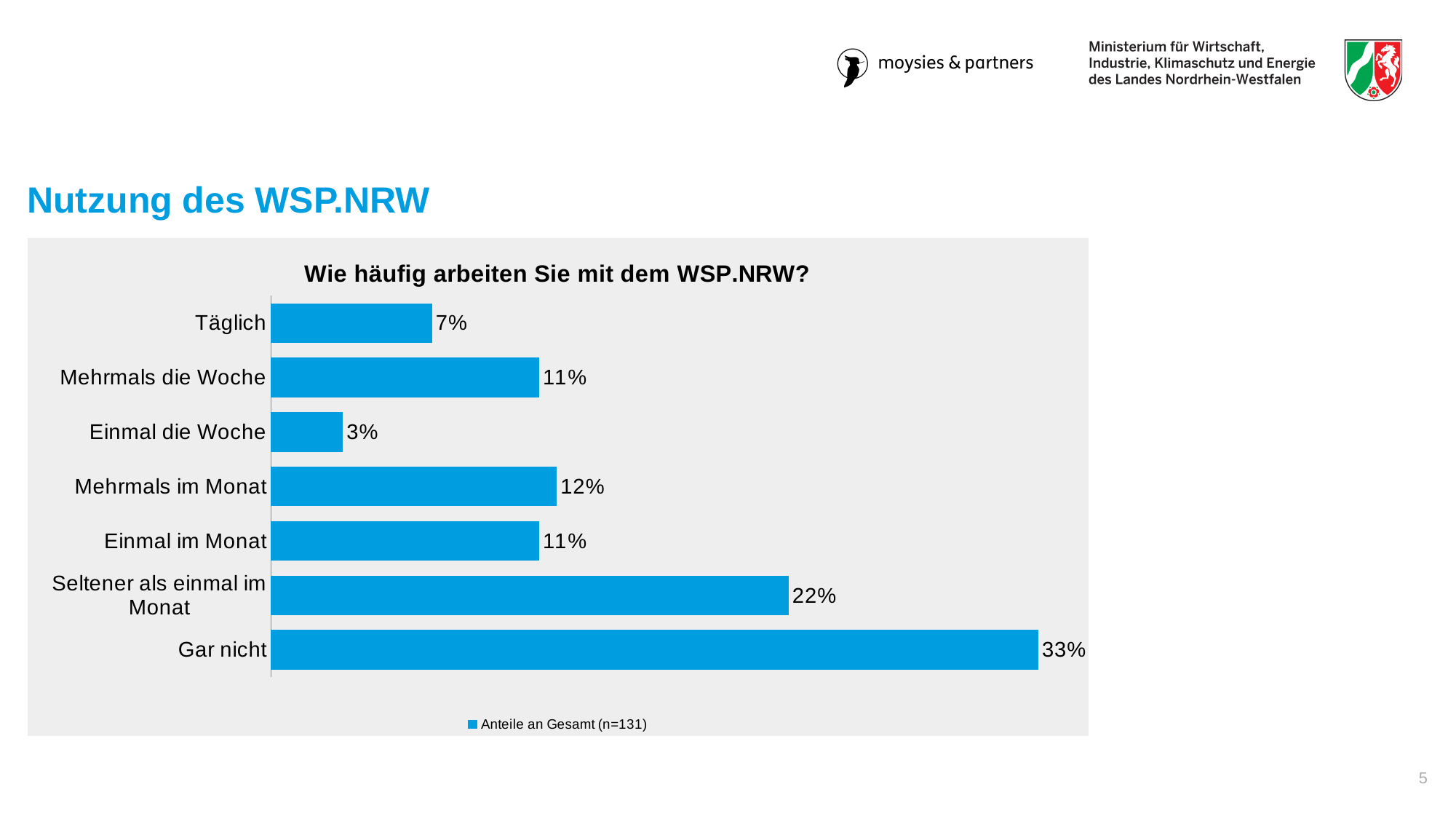
How many series does the legend list? 1 What is the title of the chart? Wie häufig arbeiten Sie mit dem WSP.NRW? What is the difference between the values for "Gar nicht" and "Seltener als einmal im Monat"? 11% Which is larger, the value for "Täglich" or the value for "Mehrmals die Woche"? Mehrmals die Woche What is the value for "Täglich"? 7% Which category has the lowest value? Einmal die Woche Which category has the highest value? Gar nicht How many categories are shown in the chart? 7 What kind of chart is shown on the slide? Bar chart What is the value for "Mehrmals im Monat"? 12% What is the value for "Seltener als einmal im Monat"? 22% What is the value for "Gar nicht"? 33%